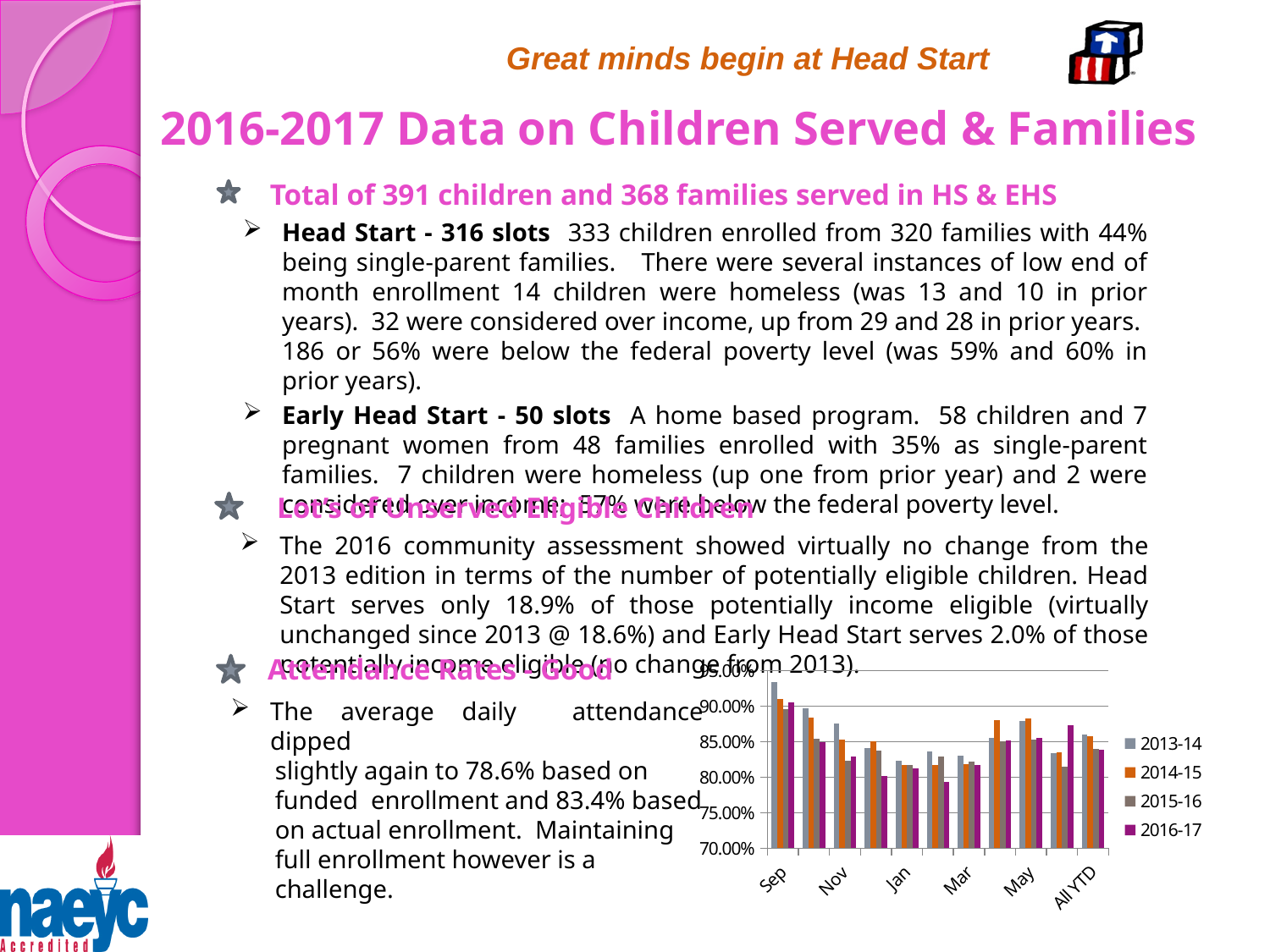
Is the value for 2016-17 in Sep greater or less than 85.00%? greater Do the 2013-14 values rise or fall from Sep to Jan? fall What is the lowest value shown on the chart's vertical axis? 70.00% How many series does the chart legend list? 4 Is the value for 2016-17 in Jan greater or less than 85.00%? less Is the value for 2016-17 in Mar greater or less than 85.00%? less What kind of chart is shown on the slide? bar chart Which is larger in Sep: the 2013-14 value or the 2016-17 value? 2013-14 Which series has the highest value in Sep? 2013-14 Which series is shown in orange in the chart legend? 2014-15